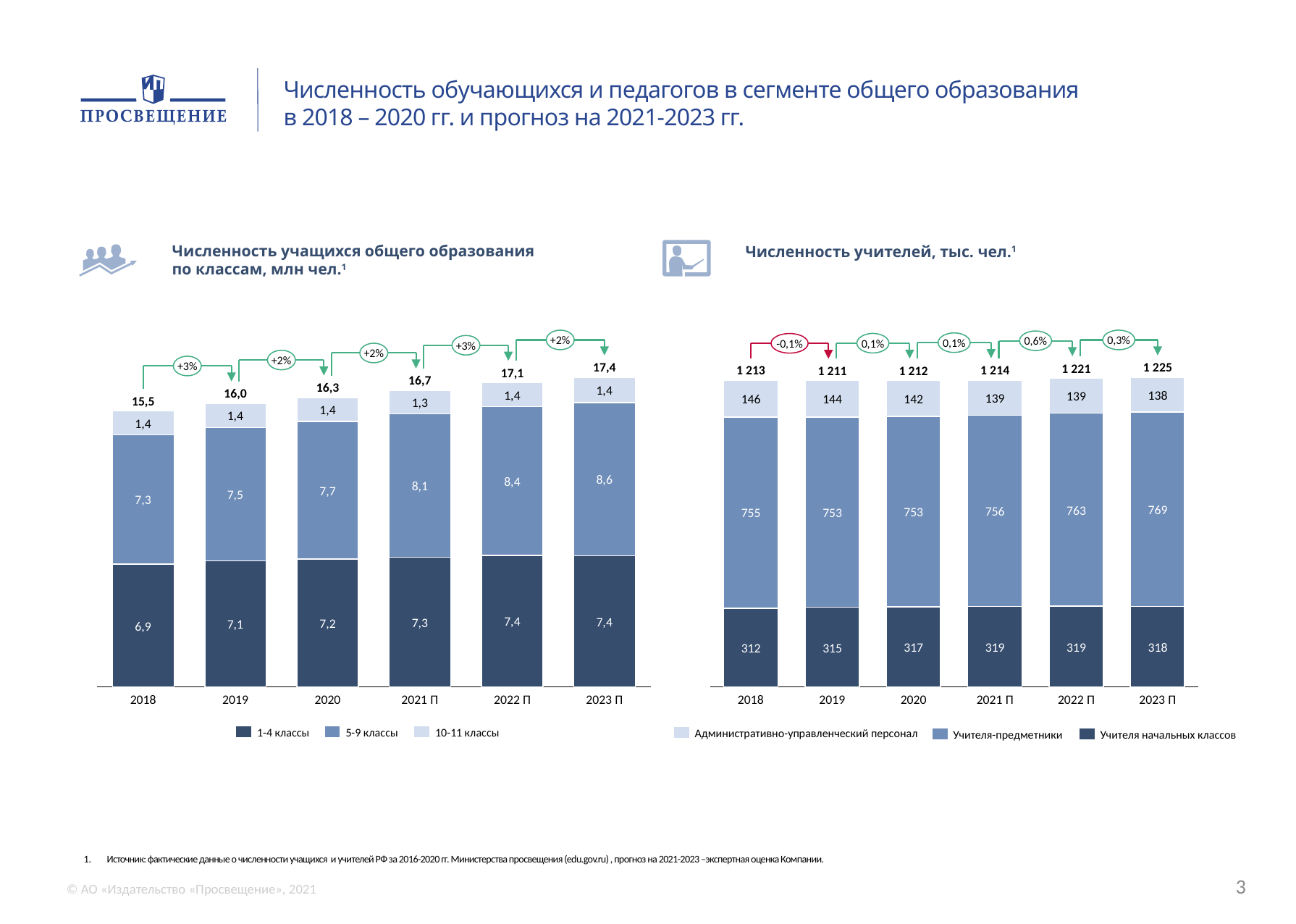
In the right chart (Численность учителей, тыс. чел.), how many years are shown on the x axis? 6 What kind of chart is the right chart (Численность учителей, тыс. чел.)? stacked bar chart In the left chart (Численность учащихся общего образования по классам, млн чел.), what is the difference between the 5-9 классы values for 2023 П and 2018? 1,3 In the left chart (Численность учащихся общего образования по классам, млн чел.), do the bar totals rise or fall from 2018 to 2023 П? rise In the left chart (Численность учащихся общего образования по классам, млн чел.), what is the total for the 2023 П bar? 17,4 In the right chart (Численность учителей, тыс. чел.), which year has the highest total? 2023 П In the right chart (Численность учителей, тыс. чел.), which is larger: Административно-управленческий персонал in 2018 or in 2023 П? 2018 In the left chart (Численность учащихся общего образования по классам, млн чел.), what is the value for 5-9 классы in 2020? 7,7 In the right chart (Численность учителей, тыс. чел.), what is the total for the 2019 bar? 1 211 In the left chart (Численность учащихся общего образования по классам, млн чел.), how many series does the legend list? 3 In the right chart (Численность учителей, тыс. чел.), what is the value for Учителя-предметники in 2022 П? 763 In the left chart (Численность учащихся общего образования по классам, млн чел.), which year has the lowest total? 2018